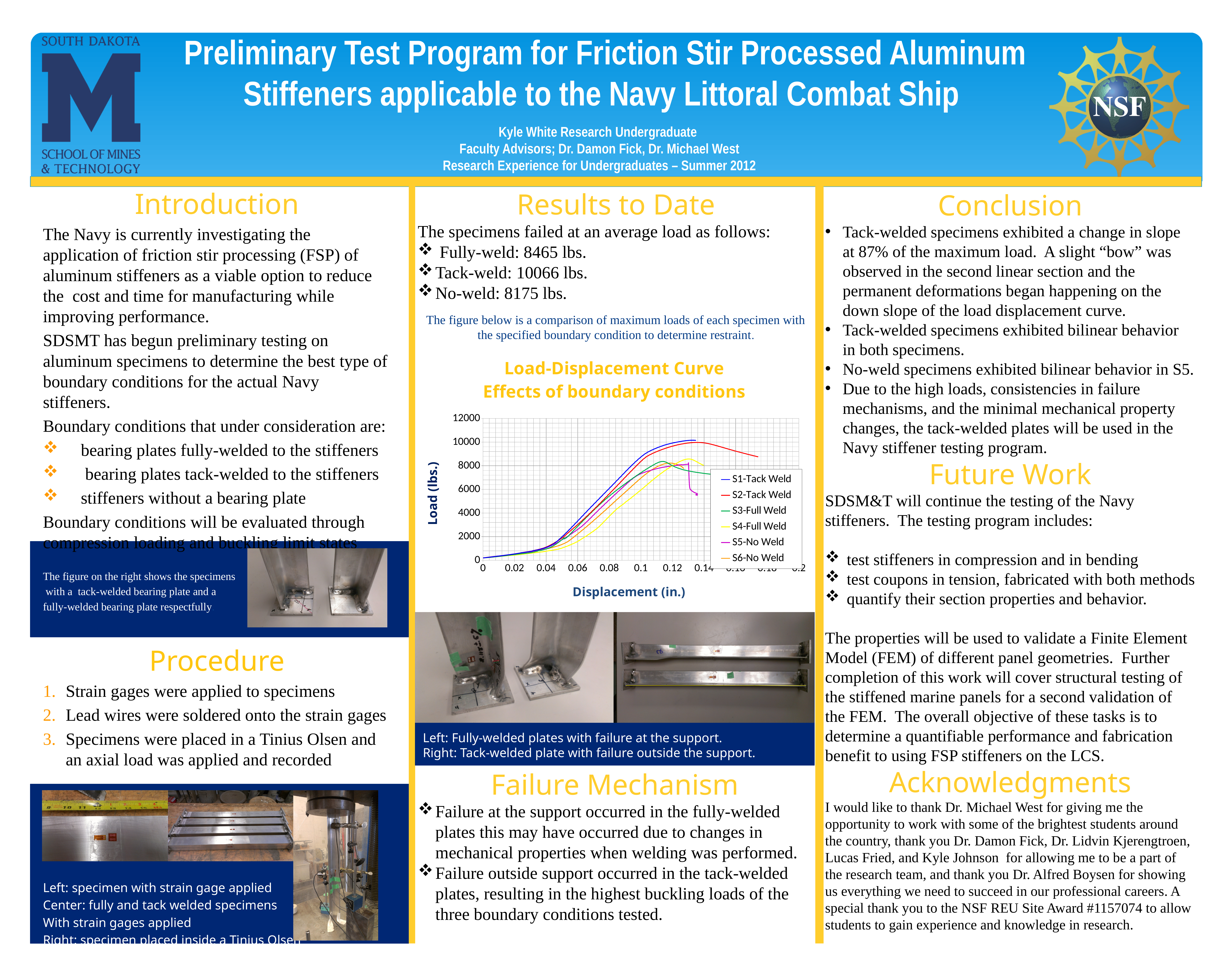
What kind of chart is the Load-Displacement Curve chart? line chart What is the label of the y axis on the Load-Displacement Curve chart? Load (lbs.) On the Load-Displacement Curve chart, is the peak load for S2-Tack Weld greater or less than 12000? less On the Load-Displacement Curve chart, does the load for S1-Tack Weld rise or fall as displacement increases from 0 to 0.1 in.? rise On the Load-Displacement Curve chart, is the load for S1-Tack Weld at a displacement of 0.04 in. greater or less than 4000? less On the Load-Displacement Curve chart, which reaches a higher peak load, S2-Tack Weld or S4-Full Weld? S2-Tack Weld On the Load-Displacement Curve chart, is the peak load for S3-Full Weld greater or less than 10000? less How many series does the legend of the Load-Displacement Curve chart list? 6 What is the title of the chart in the Results to Date section? Load-Displacement Curve Effects of boundary conditions On the Load-Displacement Curve chart, which reaches a higher peak load, S1-Tack Weld or S5-No Weld? S1-Tack Weld